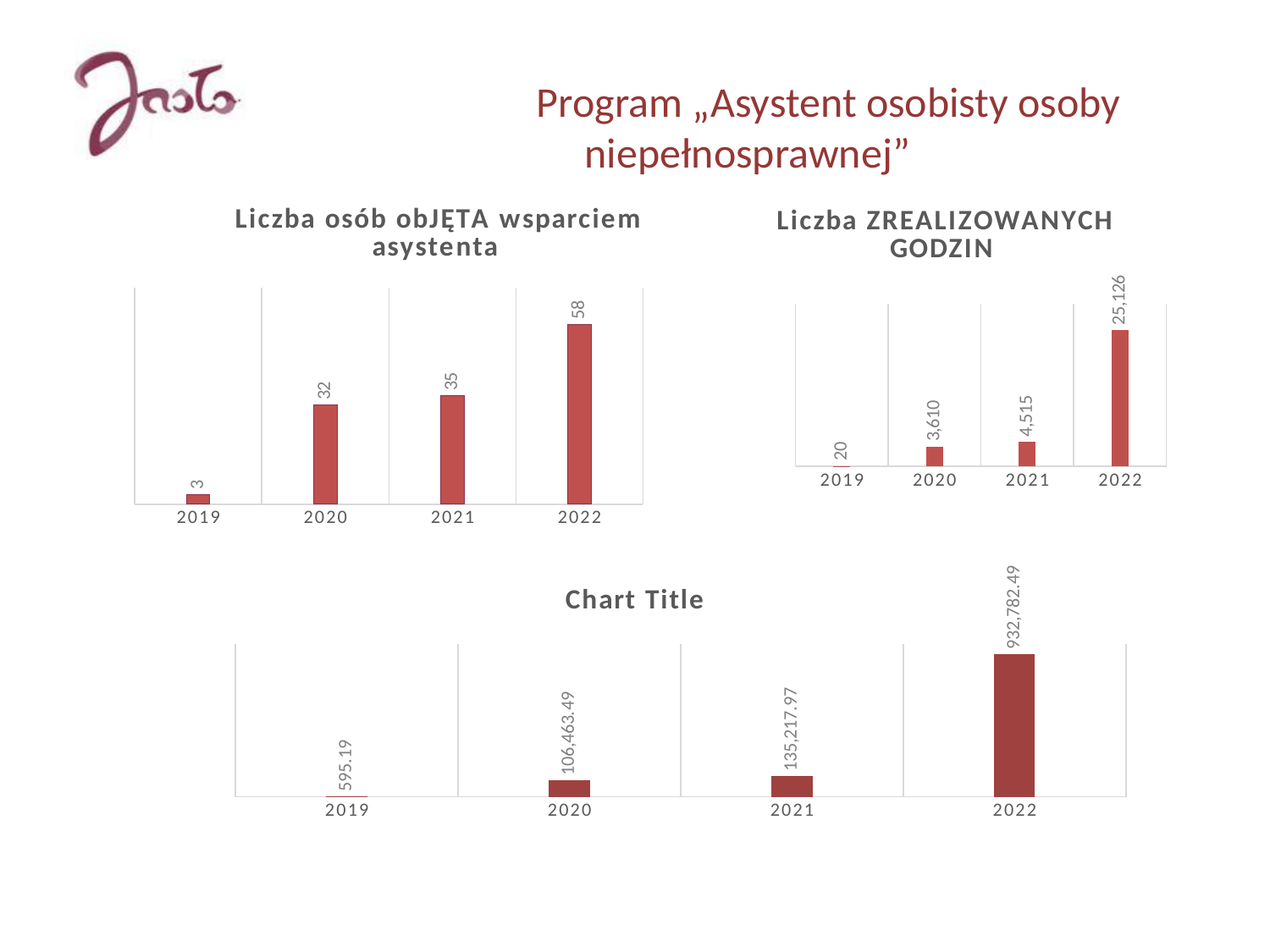
In the chart titled "Liczba ZREALIZOWANYCH GODZIN", what is the value for 2021? 4,515 In the chart titled "Chart Title" at the bottom of the slide, what is the value for 2019? 595.19 In the chart titled "Liczba osób obJĘTA wsparciem asystenta", which year has the highest value? 2022 In the chart titled "Liczba ZREALIZOWANYCH GODZIN", which is larger, the value for 2020 or the value for 2021? 2021 What kind of chart is the chart titled "Chart Title" at the bottom of the slide? bar chart In the chart titled "Chart Title" at the bottom of the slide, what is the value for 2022? 932,782.49 In the chart titled "Liczba osób obJĘTA wsparciem asystenta", what is the value for 2020? 32 In the chart titled "Liczba osób obJĘTA wsparciem asystenta", what is the value for 2019? 3 In the chart titled "Liczba ZREALIZOWANYCH GODZIN", do the values rise or fall from 2019 to 2022? rise In the chart titled "Liczba osób obJĘTA wsparciem asystenta", how many years are shown on the x axis? 4 In the chart titled "Liczba ZREALIZOWANYCH GODZIN", which year has the lowest value? 2019 In the chart titled "Liczba osób obJĘTA wsparciem asystenta", what is the difference between the values for 2022 and 2021? 23